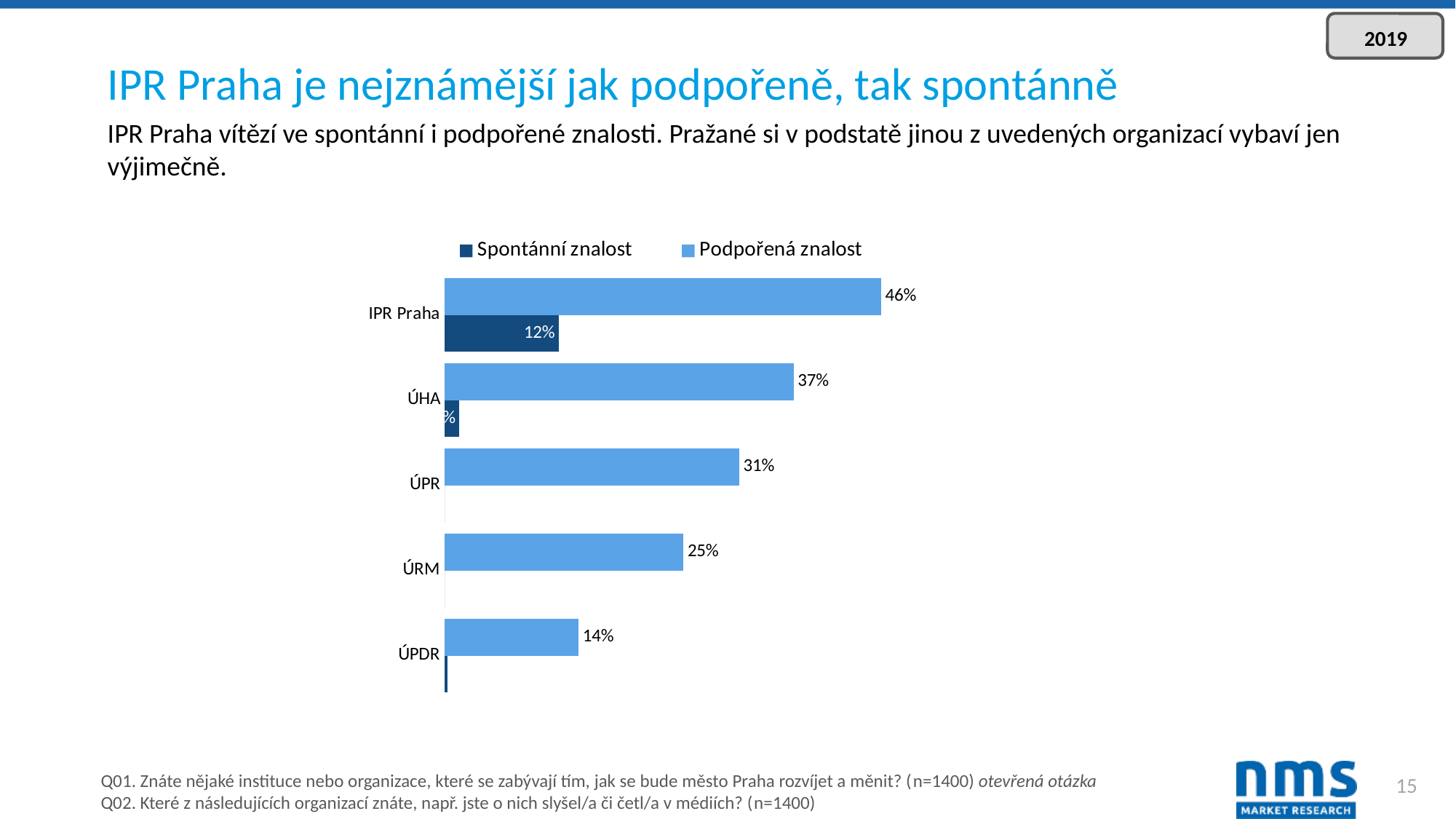
Which series is shown in dark blue in the legend? Spontánní znalost What is the difference between the Podpořená znalost values for IPR Praha and ÚHA? 9% What is the Spontánní znalost value for IPR Praha? 12% Which organization has the highest Podpořená znalost value? IPR Praha What kind of chart is shown on the slide? Bar chart What is the Podpořená znalost value for ÚHA? 37% How many series does the legend list? 2 How many organizations are shown on the chart? 5 What is the Podpořená znalost value for ÚRM? 25% Which organization has the lowest Podpořená znalost value? ÚPDR What is the Podpořená znalost value for IPR Praha? 46% Which is larger, the Podpořená znalost value for ÚPR or for ÚRM? ÚPR